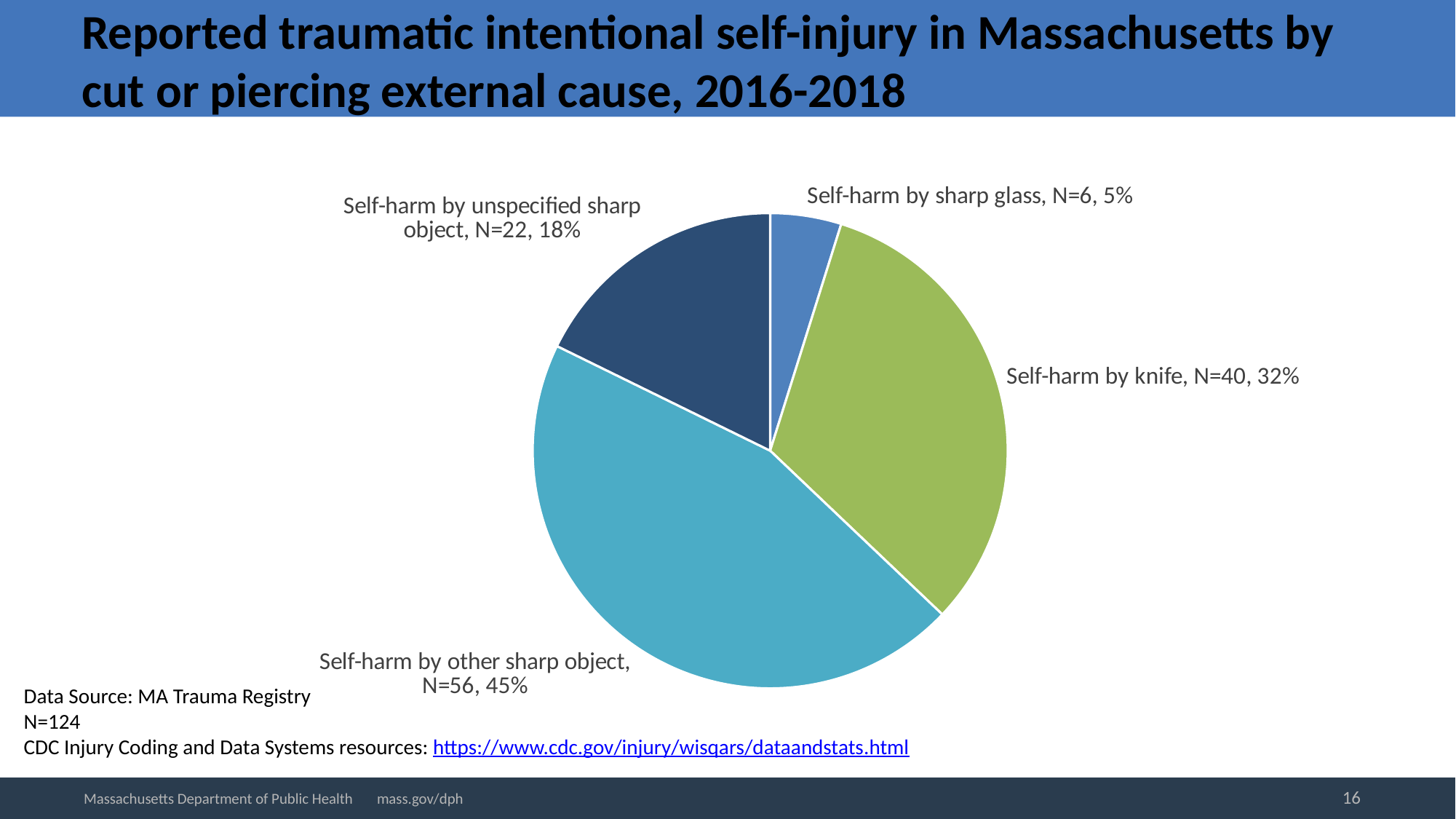
Which category has the smallest slice of the pie? Self-harm by sharp glass What is the N value for self-harm by unspecified sharp object? N=22 What share of the pie is self-harm by other sharp object? 45% What is the difference in N between self-harm by other sharp object and self-harm by knife? 16 Which is larger, the slice for self-harm by knife or the slice for self-harm by unspecified sharp object? Self-harm by knife Which category has the largest slice of the pie? Self-harm by other sharp object What is the N value for self-harm by knife? N=40 How many slices does the pie chart have? 4 What kind of chart is shown on the slide? Pie chart What percentage of the pie is self-harm by sharp glass? 5% What is the total N stated for the chart? N=124 What data source is cited for the chart? MA Trauma Registry